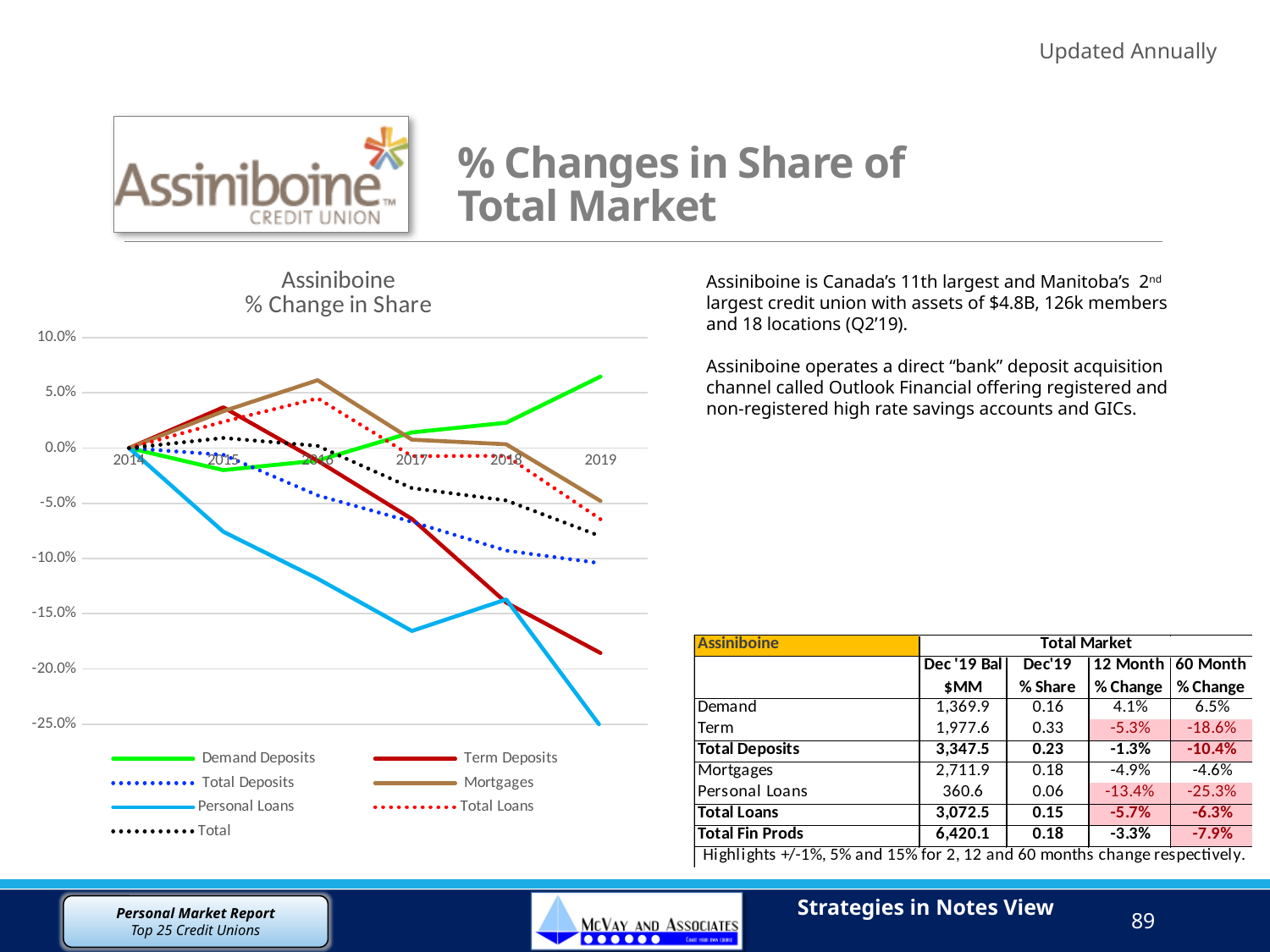
Is the value for Term Deposits in 2019 greater or less than -15.0%? less What is the title of the chart? Assiniboine % Change in Share Is the value for Mortgages in 2016 greater or less than 5.0%? greater How many years are shown along the x axis of the chart? 6 Does the Personal Loans line rise or fall overall from 2014 to 2019? fall How many series does the chart legend list? 7 Which series has the lowest value in 2019? Personal Loans What kind of chart is shown on the slide? line chart Is the value for Demand Deposits in 2019 greater or less than 5.0%? greater Which series has the highest value in 2019? Demand Deposits In 2019, which is larger: the value for Mortgages or the value for Term Deposits? Mortgages